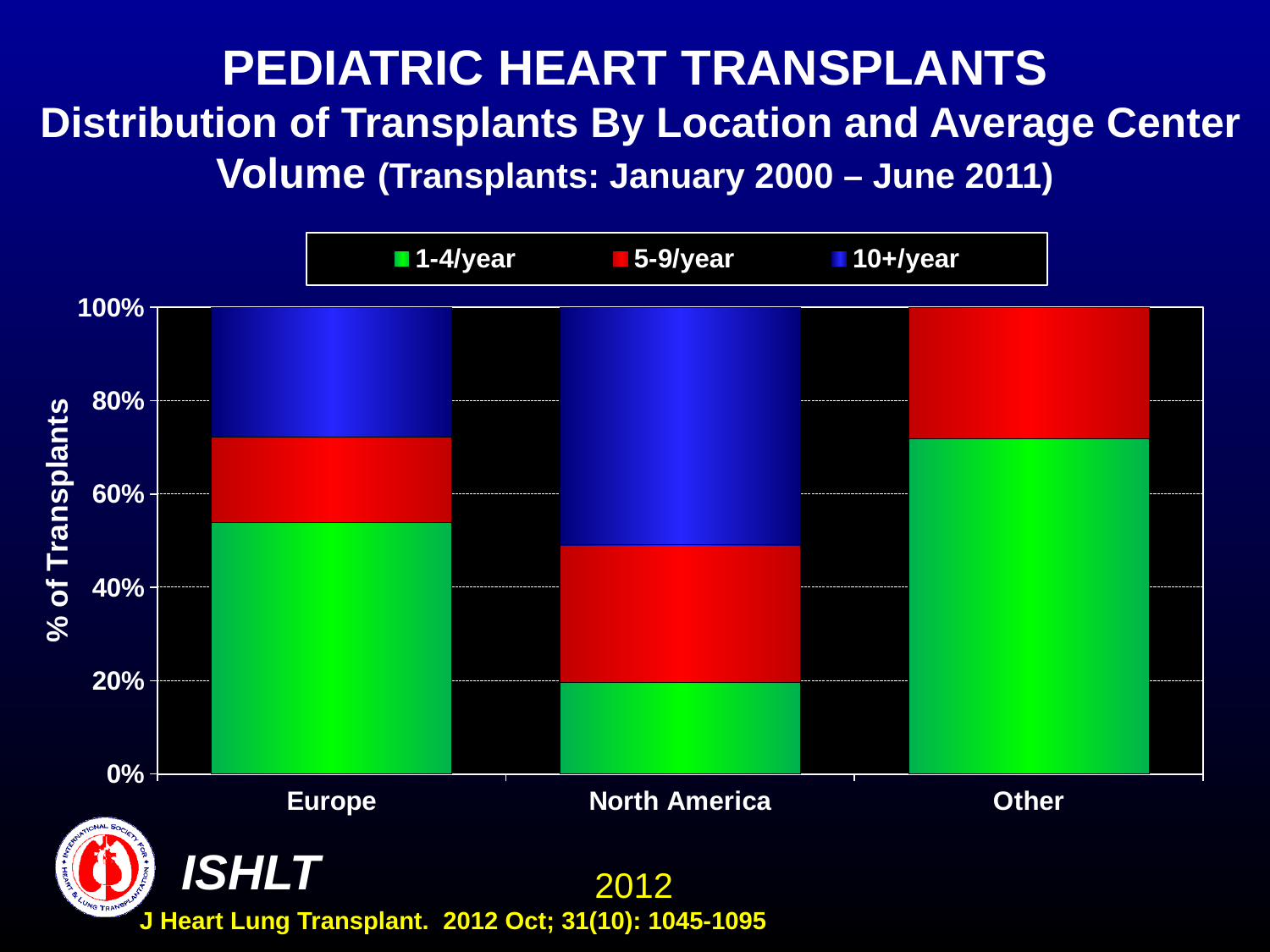
Is the 1-4/year share for Other greater or less than 60%? greater What is the label on the y axis of the chart? % of Transplants Which location has the smallest share of transplants in the 1-4/year category? North America Is the 1-4/year share for Europe greater or less than 40%? greater Which location has a larger 1-4/year share, Europe or North America? Europe What is the total height of the stacked bar for Europe? 100% Which location has the largest share of transplants in the 1-4/year category? Other How many locations are shown on the x axis of the chart? 3 How many series does the chart's legend list? 3 Is the 1-4/year share for North America greater or less than 40%? less Which location has the largest share of transplants in the 10+/year category? North America What kind of chart is shown on the slide? Stacked bar chart